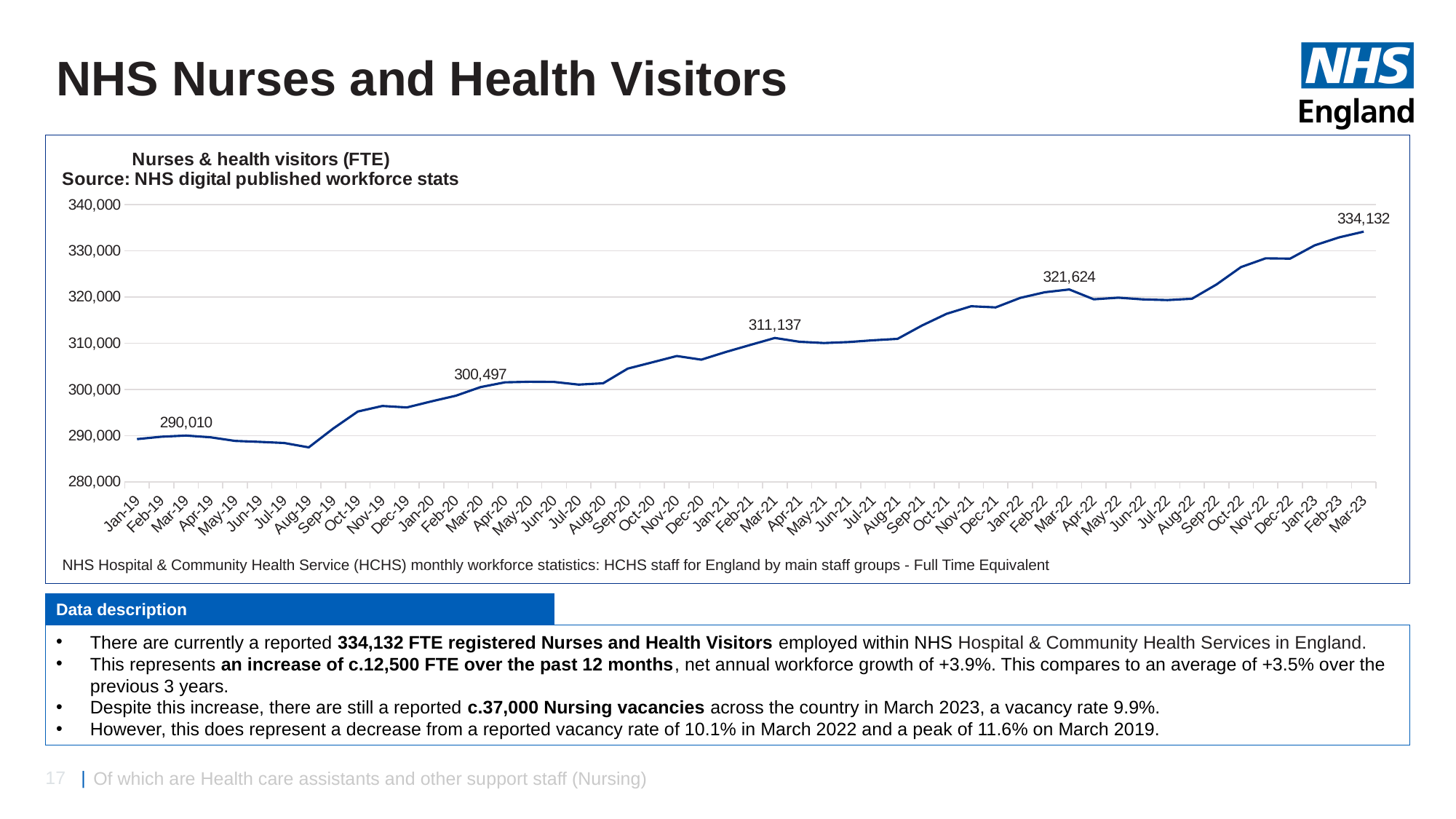
What is the difference between the values for Mar-23 and Mar-22? 12,508 Which month has the highest value on the chart? Mar-23 What type of chart is shown on the slide? Line chart What is the value for Mar-21? 311,137 What is the value for Mar-19? 290,010 What is the difference between the values for Mar-20 and Mar-19? 10,487 Is the value for Oct-22 greater or less than 320,000? greater Which month has the lowest value on the chart? Aug-19 What is the value for Mar-22? 321,624 Do the values generally rise or fall from Jan-19 to Mar-23? Rise What is the title of the chart? Nurses & health visitors (FTE) What is the value for Mar-23? 334,132